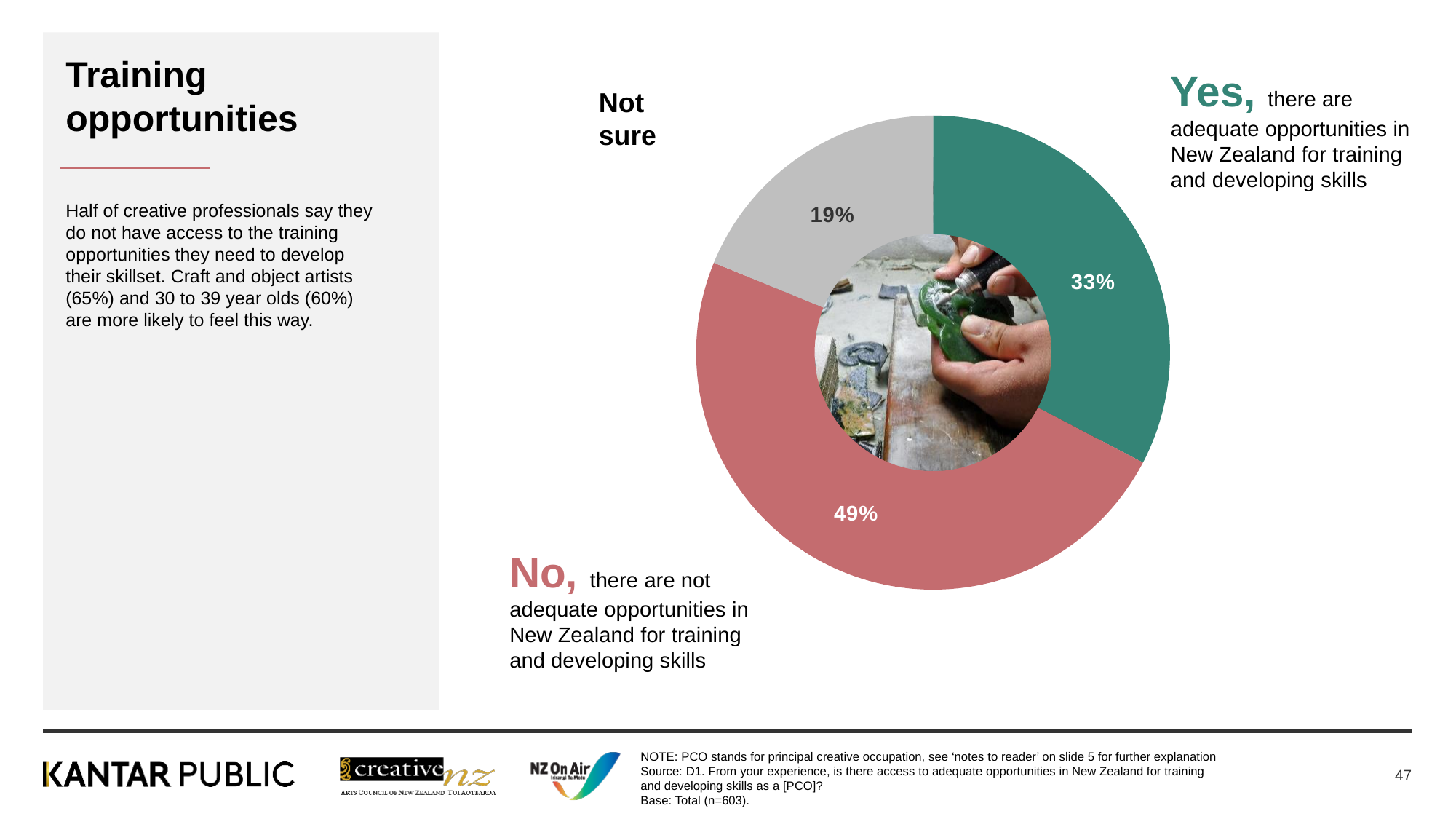
What is the difference in percentage points between the Yes and Not sure responses? 14 Which response has the largest share of the chart? No What percentage of respondents said No, there are not adequate opportunities for training and developing skills? 49% Which is larger, the share for Yes or the share for Not sure? Yes What kind of chart is shown on the slide? Pie chart (doughnut) What colour is the segment representing the Yes response? Green What colour is the segment representing the No response? Red What percentage of respondents were Not sure? 19% Which response has the smallest share of the chart? Not sure How many segments does the chart have? 3 What percentage of respondents said Yes, there are adequate opportunities in New Zealand for training and developing skills? 33% What is the difference in percentage points between the No and Yes responses? 16